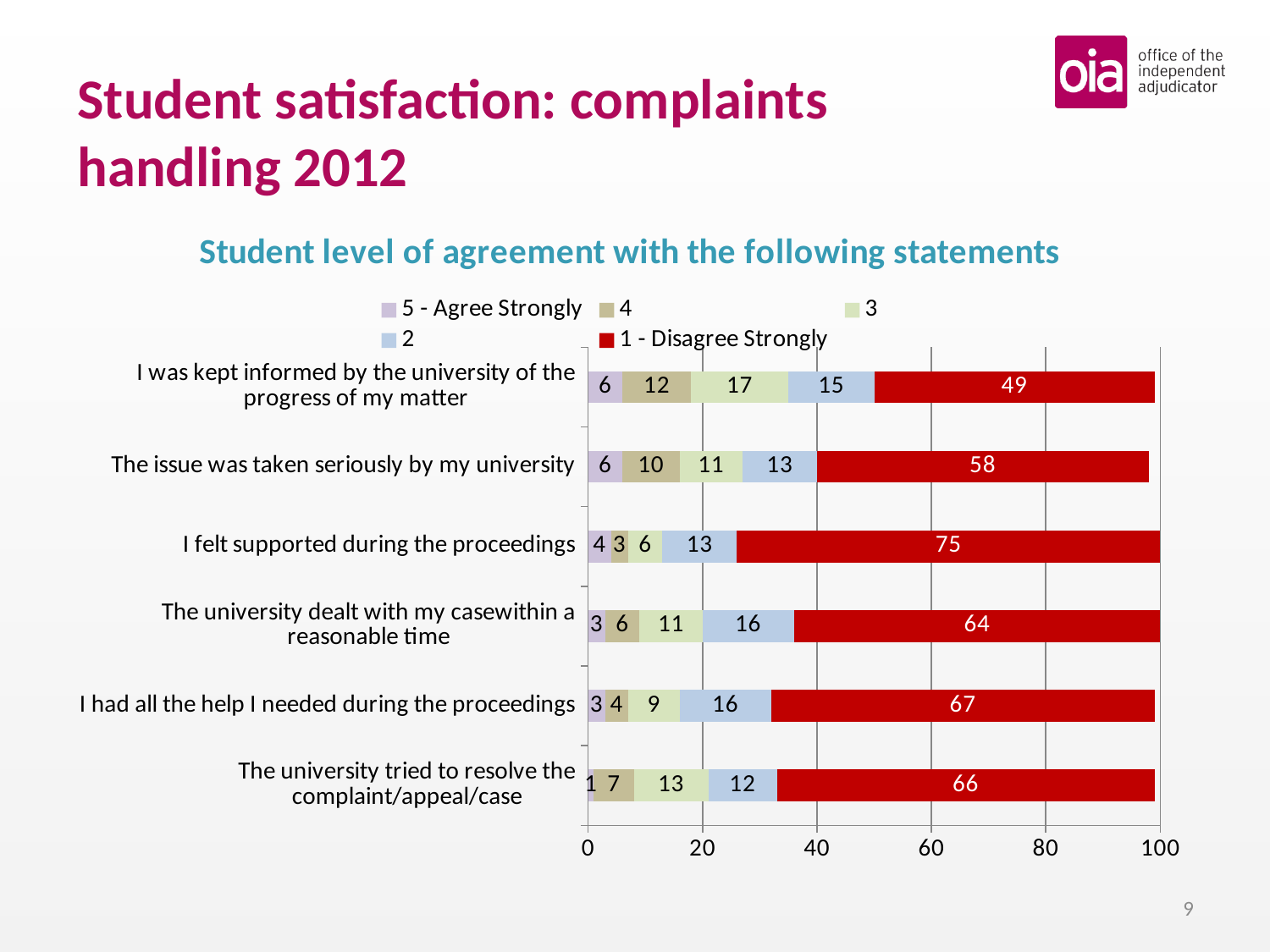
What is the value of '3' for 'I was kept informed by the university of the progress of my matter'? 17 How many series does the legend list? 5 What is the title shown above the chart? Student level of agreement with the following statements What is the difference between the '1 - Disagree Strongly' values for 'I felt supported during the proceedings' and 'I was kept informed by the university of the progress of my matter'? 26 Which statement has the highest '1 - Disagree Strongly' value? I felt supported during the proceedings What is the value of '1 - Disagree Strongly' for 'I felt supported during the proceedings'? 75 What is the value of '2' for 'The university dealt with my case within a reasonable time'? 16 What kind of chart is shown on the slide? stacked bar chart What is the total of the stacked bar for 'The issue was taken seriously by my university'? 98 How many statements (categories) are plotted in the chart? 6 Which is larger: the '1 - Disagree Strongly' value for 'The issue was taken seriously by my university' or for 'The university tried to resolve the complaint/appeal/case'? The university tried to resolve the complaint/appeal/case Which statement has the lowest '1 - Disagree Strongly' value? I was kept informed by the university of the progress of my matter